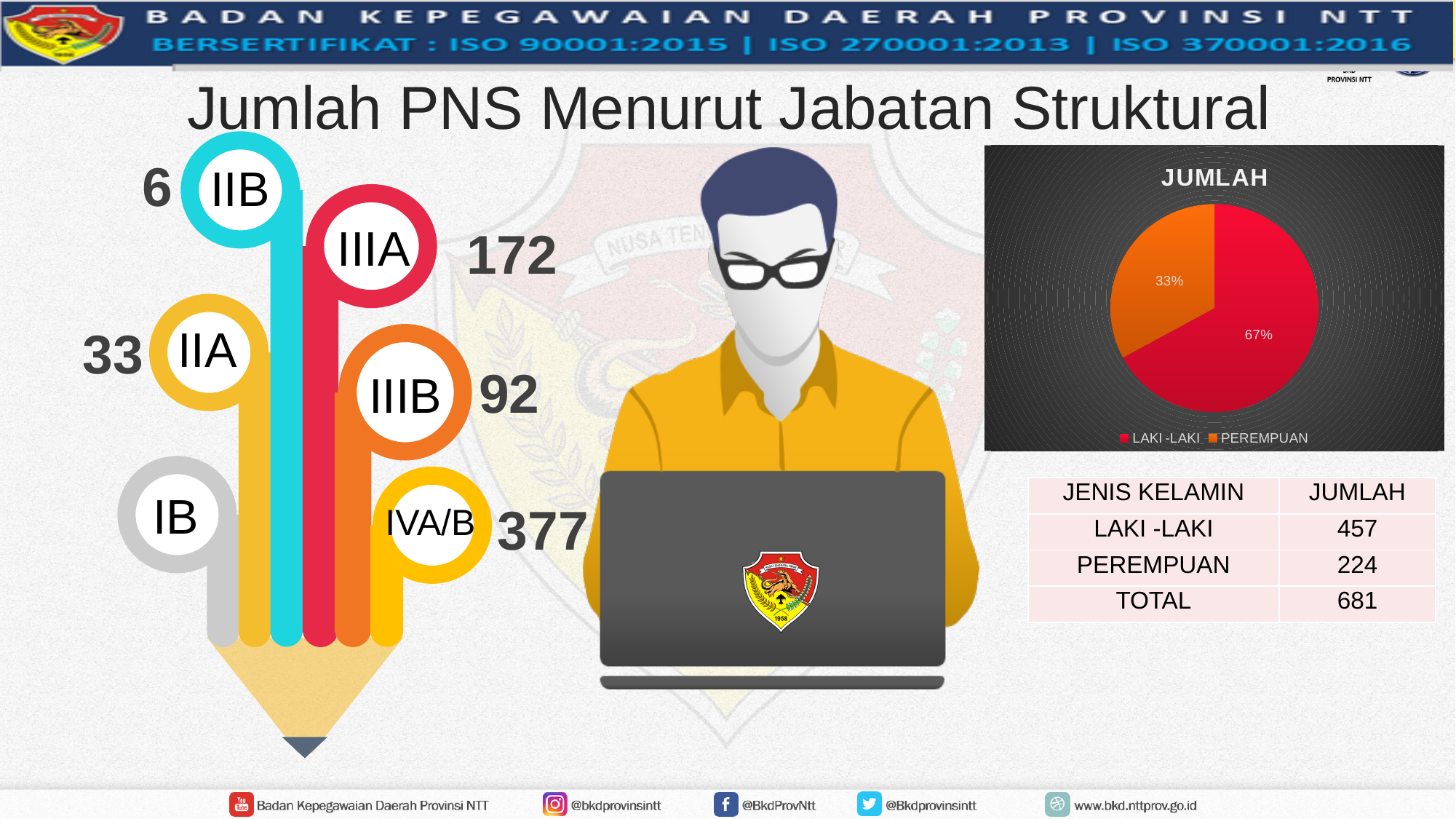
In the "JUMLAH" pie chart, by how many percentage points does the LAKI -LAKI share exceed the PEREMPUAN share? 34 percentage points How many slices does the "JUMLAH" pie chart have? 2 What is the title of the pie chart on the right of the slide? JUMLAH How many entries does the legend of the "JUMLAH" pie chart list? 2 In the "JUMLAH" pie chart, which category has the smallest slice? PEREMPUAN In the "JUMLAH" pie chart, what percentage is shown for PEREMPUAN? 33% In the "JUMLAH" pie chart, what percentage is shown for LAKI -LAKI? 67% What kind of chart is the chart titled "JUMLAH" on the right of the slide? pie chart In the "JUMLAH" pie chart, which is larger, the LAKI -LAKI slice or the PEREMPUAN slice? LAKI -LAKI In the "JUMLAH" pie chart, what share of the pie does the PEREMPUAN slice represent? 33% In the "JUMLAH" pie chart, which category has the largest slice? LAKI -LAKI In the "JUMLAH" pie chart, what colour is the LAKI -LAKI slice? red